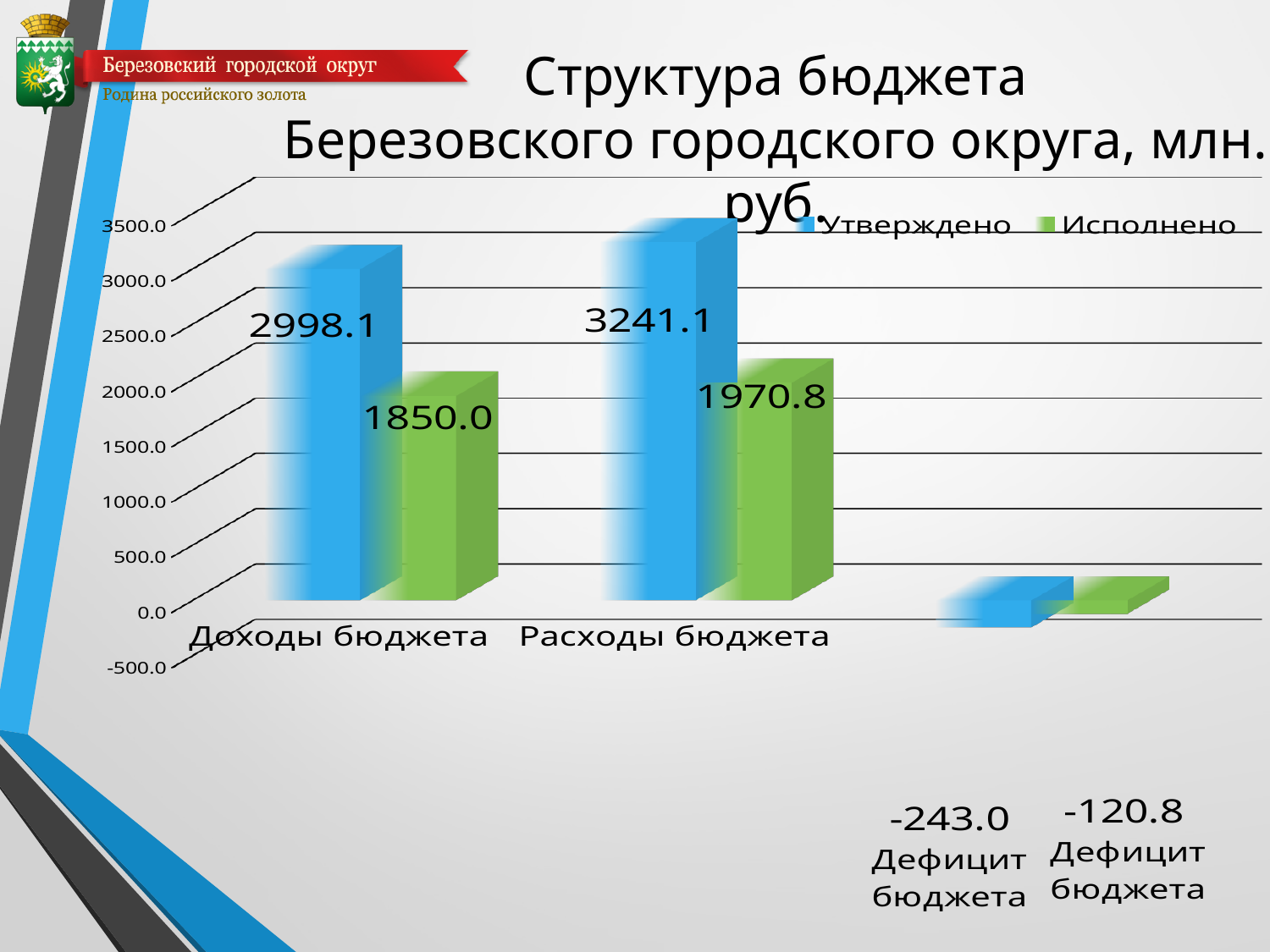
What is the Исполнено value for Расходы бюджета? 1970.8 Which series is shown in green in the legend? Исполнено What is the Утверждено value for Доходы бюджета? 2998.1 How many series does the legend list? 2 What type of chart is shown on the slide? bar chart What is the Утверждено value for Расходы бюджета? 3241.1 What is the Исполнено value for Доходы бюджета? 1850.0 What is the Исполнено value for Дефицит бюджета? -120.8 Which category has the highest Утверждено value? Расходы бюджета Which is larger: the Исполнено value for Доходы бюджета or the Исполнено value for Расходы бюджета? Расходы бюджета What is the Утверждено value for Дефицит бюджета? -243.0 What is the difference between the Утверждено and Исполнено values for Расходы бюджета? 1270.3